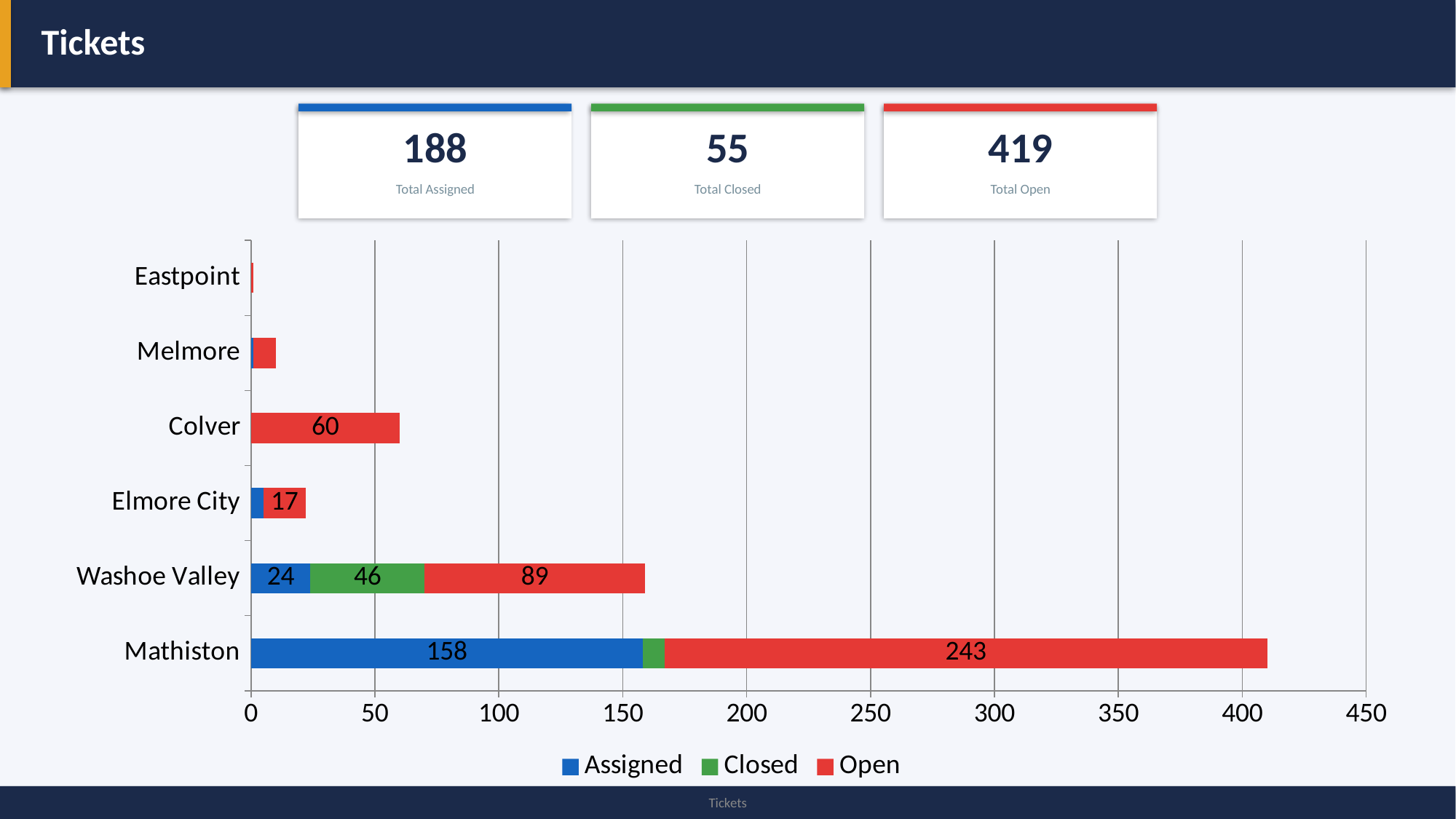
What is the Open value for Colver? 60 How many series does the legend list? 3 Is the total bar length for Mathiston greater or less than 400? greater How many locations are shown on the chart? 6 What is the difference between the Open and Assigned values for Mathiston? 85 What kind of chart is shown on the slide? Stacked bar chart What is the total of the stacked bar for Washoe Valley? 159 What is the Assigned value for Mathiston? 158 Which location has the longest total bar? Mathiston Which location has the shortest total bar? Eastpoint What is the Closed value for Washoe Valley? 46 Which has a larger Open value, Colver or Elmore City? Colver